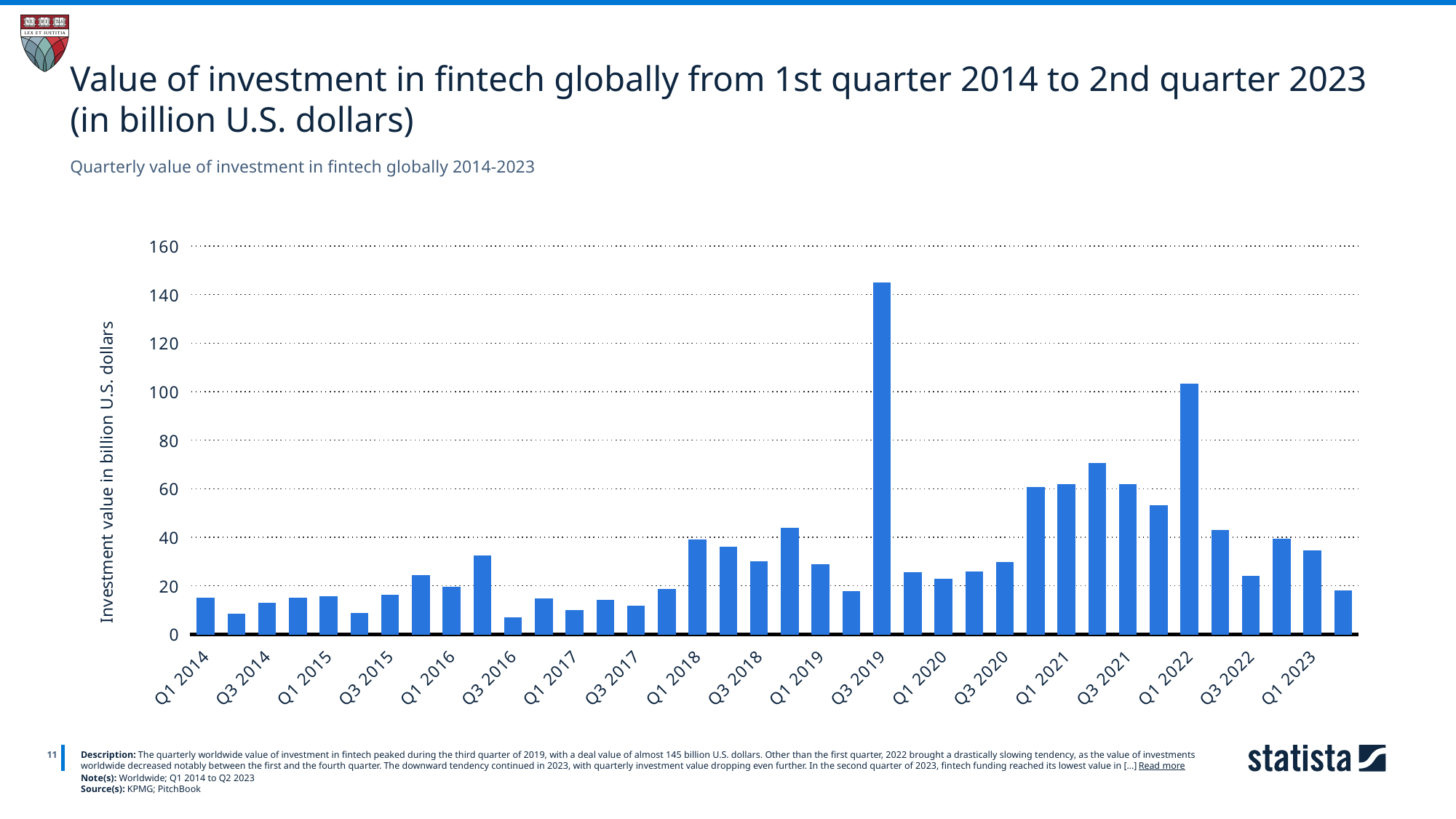
Is the value for Q3 2018 greater or less than 40? less Which is larger, the value for Q1 2021 or the value for Q1 2014? Q1 2021 Which is larger, the value for Q3 2019 or the value for Q1 2022? Q3 2019 What is the label of the vertical axis? Investment value in billion U.S. dollars Is the value for Q1 2014 greater or less than 20? less Is the value for Q3 2016 greater or less than 20? less How many quarterly bars are plotted in the chart? 38 Which quarter has the highest fintech investment value? Q3 2019 What kind of chart is shown on the slide? bar chart